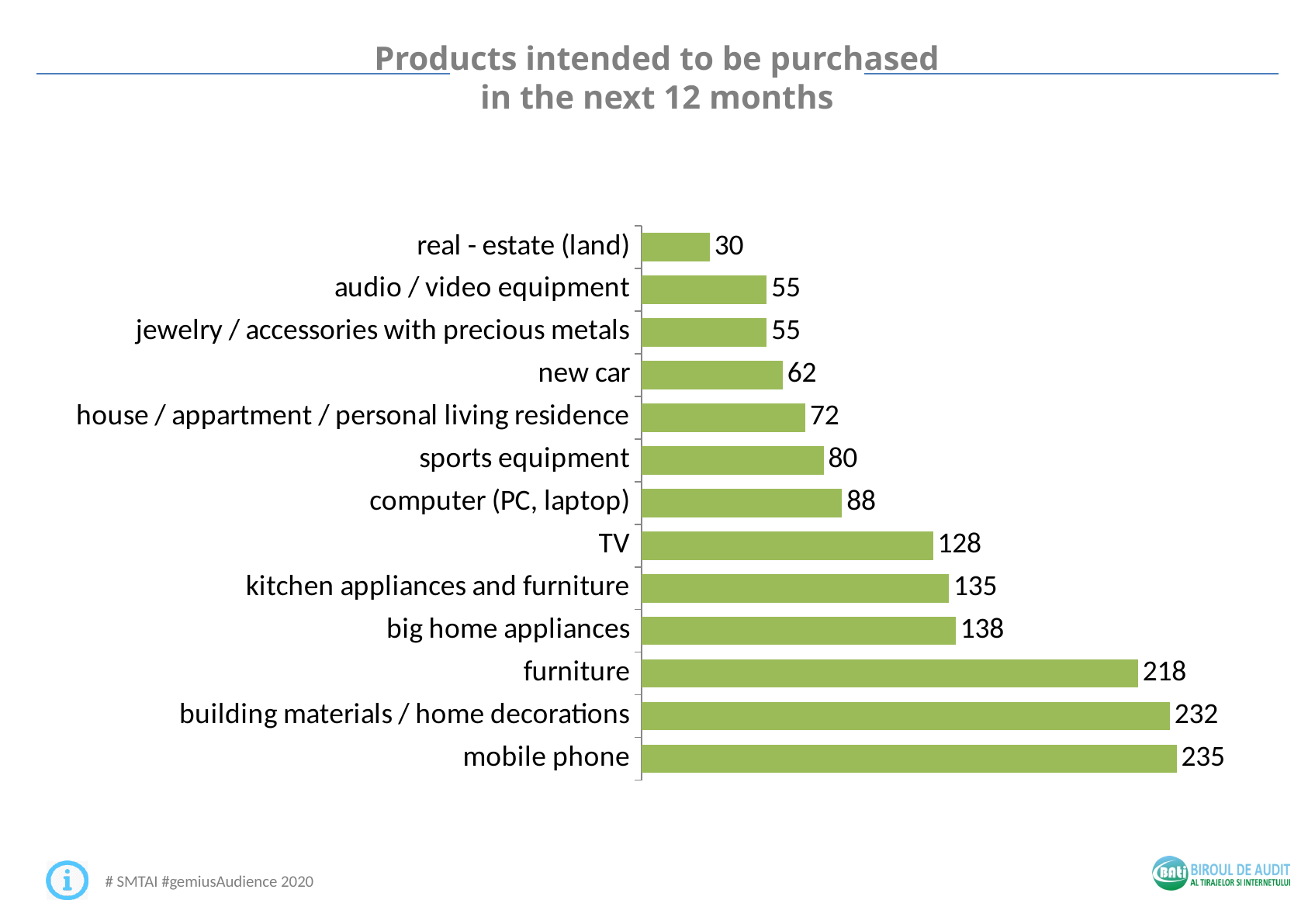
What is the difference between the values for big home appliances and new car? 76 Which category has the highest value? mobile phone How many categories are shown in the chart? 13 What kind of chart is shown on the slide? bar chart What is the value for TV? 128 What is the title of the chart? Products intended to be purchased in the next 12 months Which category has the lowest value? real - estate (land) What is the difference between the values for furniture and computer (PC, laptop)? 130 What is the value for sports equipment? 80 Which is larger, the value for kitchen appliances and furniture or the value for TV? kitchen appliances and furniture What is the value for mobile phone? 235 Which is larger, the value for house / appartment / personal living residence or the value for audio / video equipment? house / appartment / personal living residence